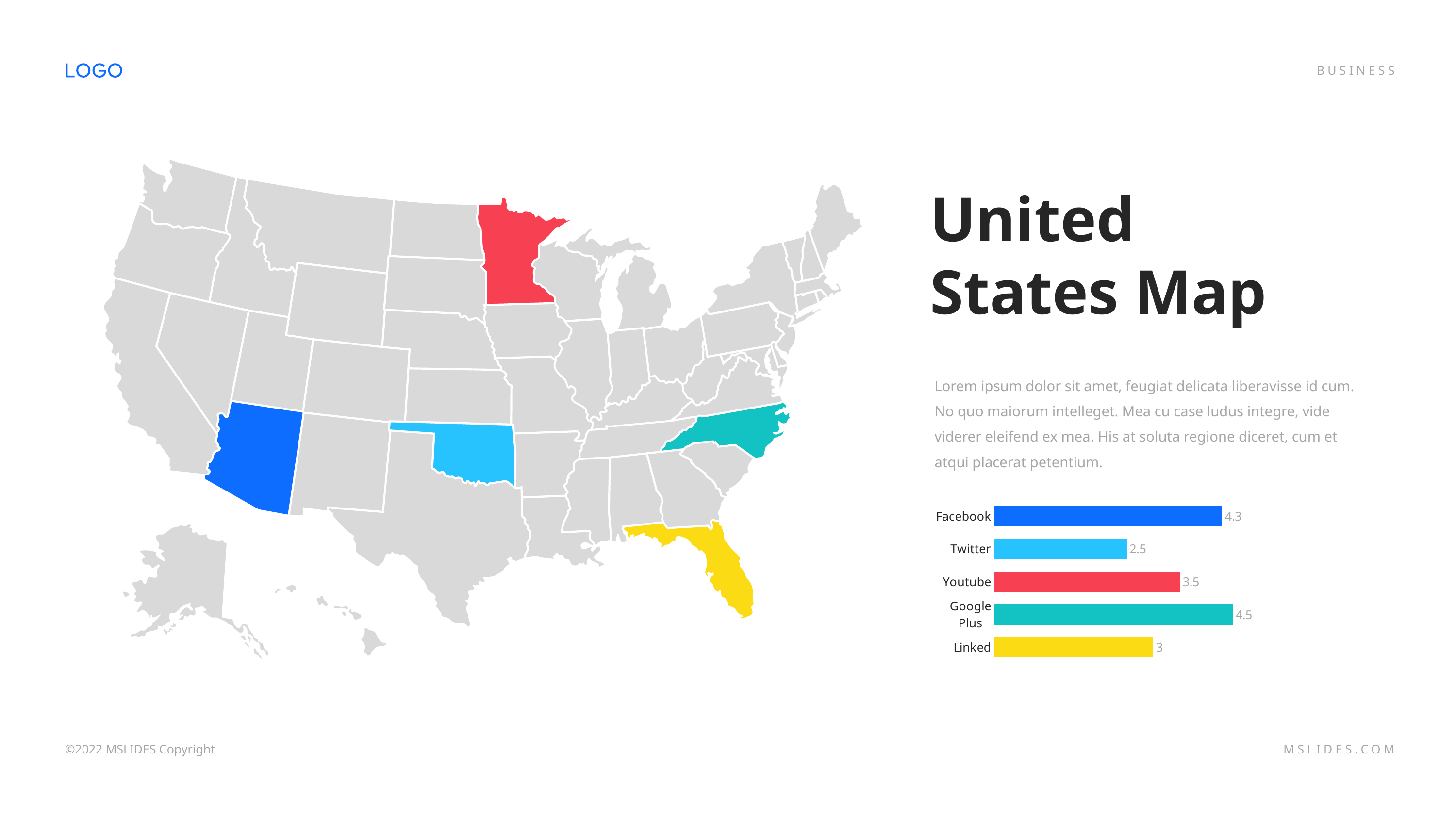
What is the difference between the values for Facebook and Youtube? 0.8 Which category has the highest value in the bar chart? Google Plus What is the value for Youtube in the bar chart? 3.5 What is the value for Twitter in the bar chart? 2.5 How many categories are shown in the bar chart? 5 What kind of chart is shown on the slide? Bar chart What is the value for Facebook in the bar chart? 4.3 Which category has the lowest value in the bar chart? Twitter What is the value for Linked in the bar chart? 3 Which has a larger value, Youtube or Linked? Youtube What is the difference between the values for Google Plus and Twitter? 2 What is the value for Google Plus in the bar chart? 4.5